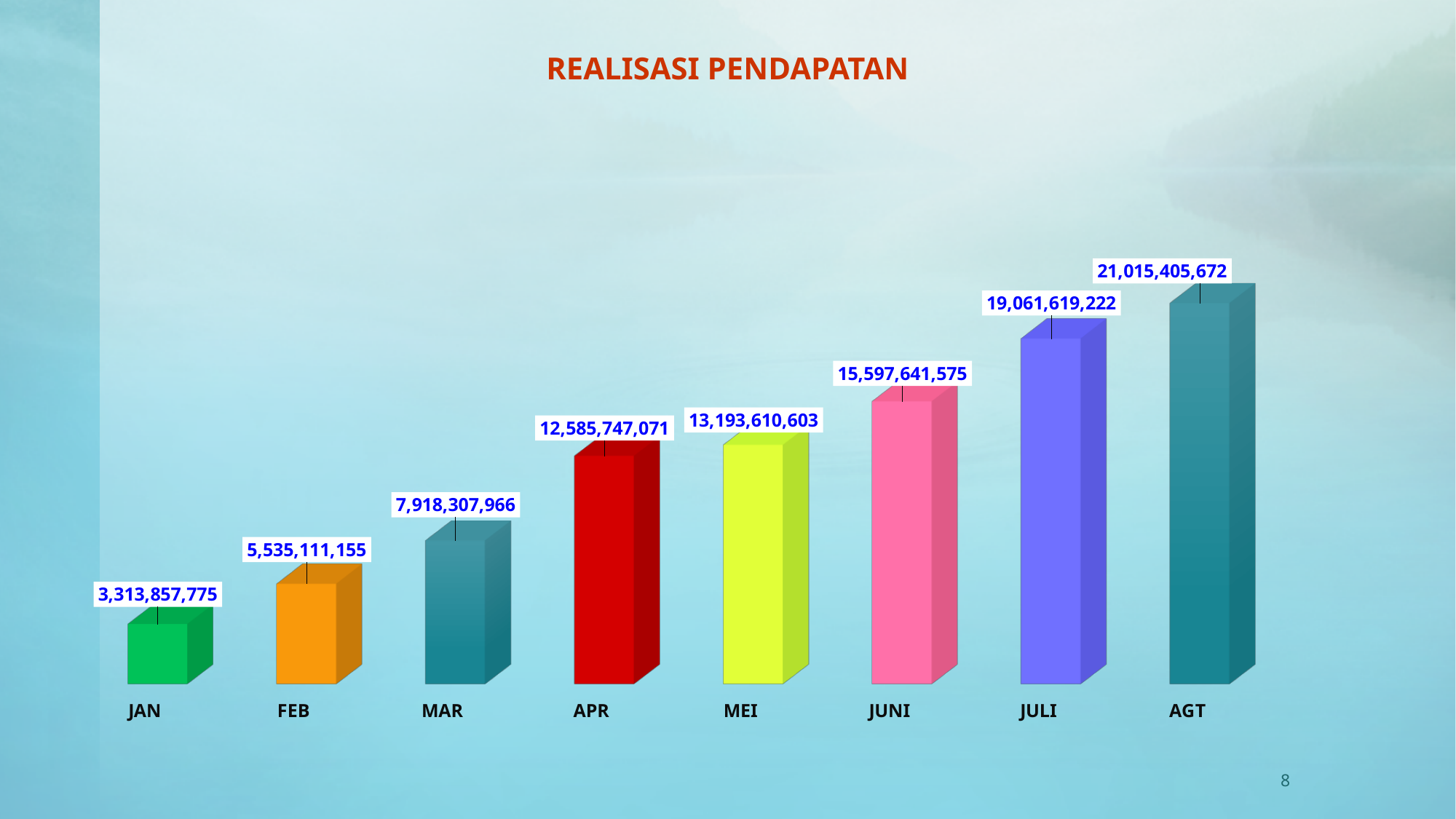
What is the value for JAN? 3,313,857,775 Which month has the highest value? AGT What is the difference between the values for AGT and JULI? 1,953,786,450 Do the values rise or fall from JAN to AGT? rise What is the value for JUNI? 15,597,641,575 What is the title of the chart? REALISASI PENDAPATAN How many months are shown on the chart? 8 What is the difference between the values for FEB and JAN? 2,221,253,380 Which month has the lowest value? JAN What kind of chart is this? bar chart What is the value for APR? 12,585,747,071 Which is larger, the value for MAR or the value for MEI? MEI